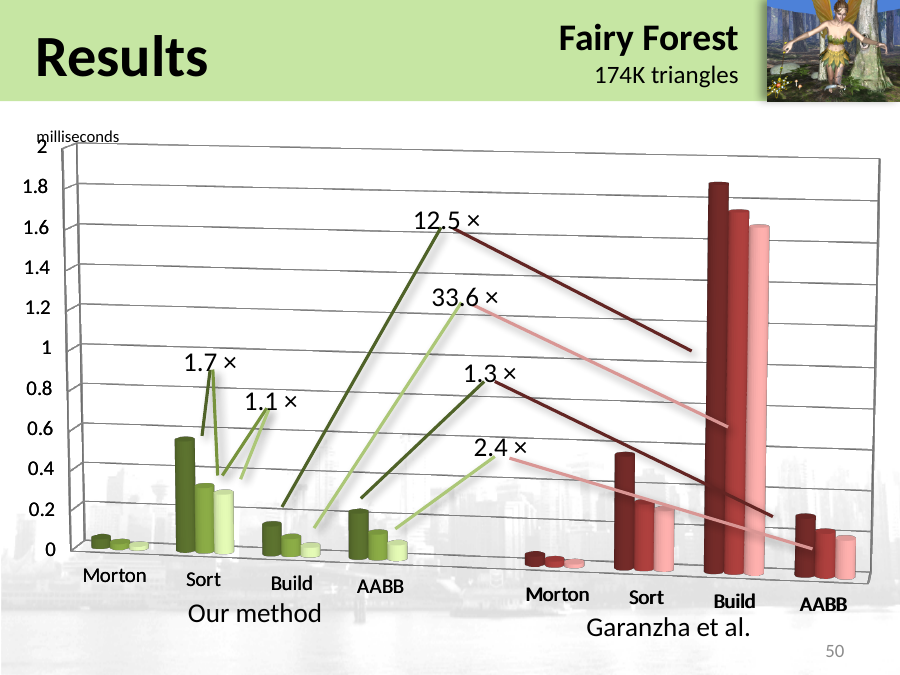
Is the tallest Sort bar for Our method greater or less than 0.4? greater What unit is shown on the vertical axis of the chart? milliseconds Is the tallest AABB bar for Garanzha et al. greater or less than 0.4? less Which category has the tallest bar in the chart? Build (Garanzha et al.) How many categories are labelled along the x axis of the chart in total? 8 What kind of chart is shown on the slide? bar chart Is the tallest Build bar for Our method greater or less than 0.2? less How many method groups are compared in the chart? 2 Which has the larger Build bars, Our method or Garanzha et al.? Garanzha et al.